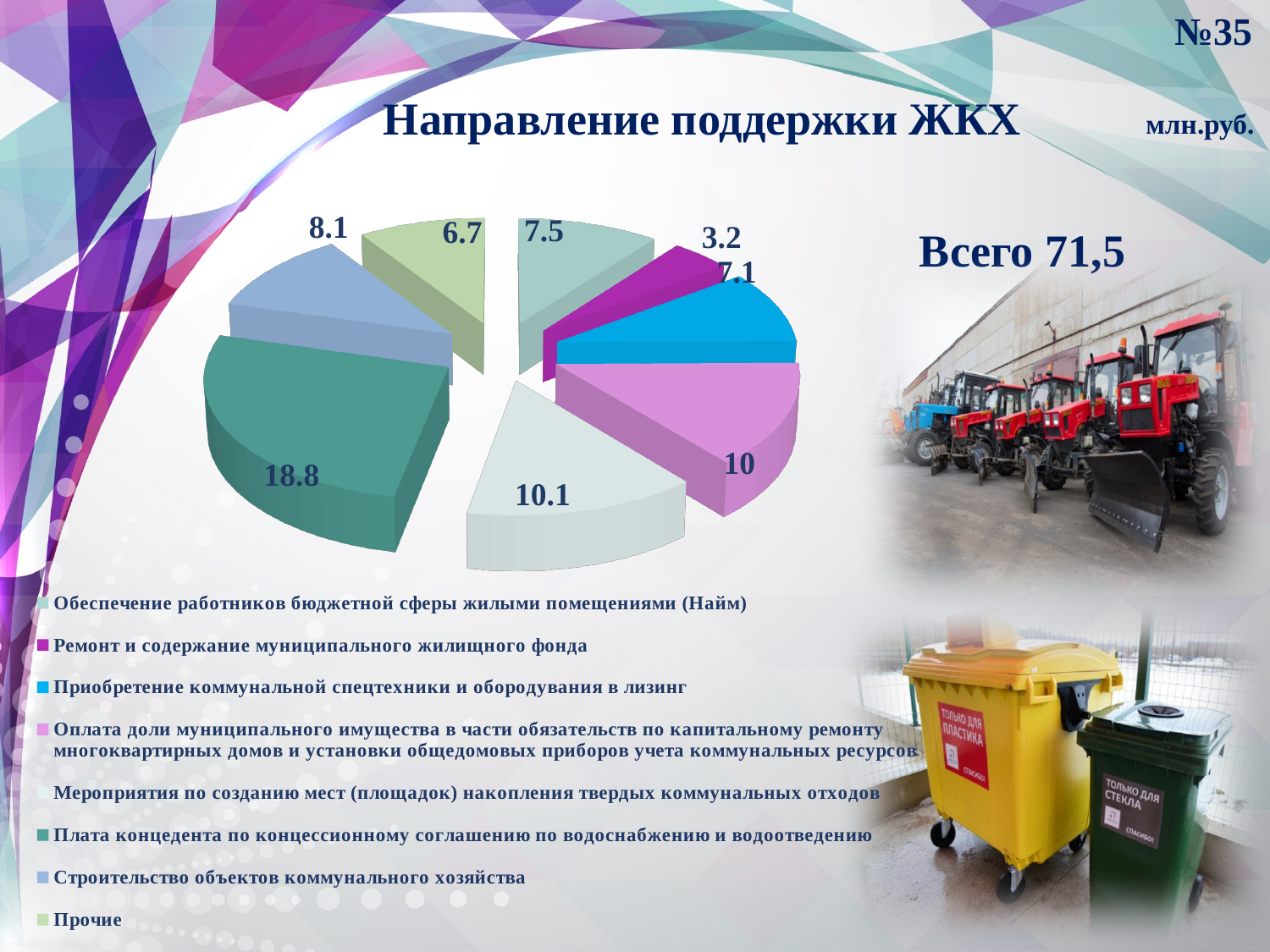
Which is larger: the value for «Обеспечение работников бюджетной сферы жилыми помещениями (Найм)» or for «Прочие»? Обеспечение работников бюджетной сферы жилыми помещениями (Найм) How many categories does the pie chart show? 8 What is the value for «Ремонт и содержание муниципального жилищного фонда»? 3.2 What is the value for «Плата концедента по концессионному соглашению по водоснабжению и водоотведению»? 18.8 Which category has the smallest slice of the pie? Ремонт и содержание муниципального жилищного фонда What total value is stated on the slide for the chart? 71,5 Which category has the largest slice of the pie? Плата концедента по концессионному соглашению по водоснабжению и водоотведению What is the difference between the values for «Плата концедента по концессионному соглашению по водоснабжению и водоотведению» and «Мероприятия по созданию мест (площадок) накопления твердых коммунальных отходов»? 8.7 What kind of chart is shown on the slide? Pie chart What unit is stated for the chart values? млн.руб. What is the value for «Строительство объектов коммунального хозяйства»? 8.1 What is the value for «Приобретение коммунальной спецтехники и оборудования в лизинг»? 7.1